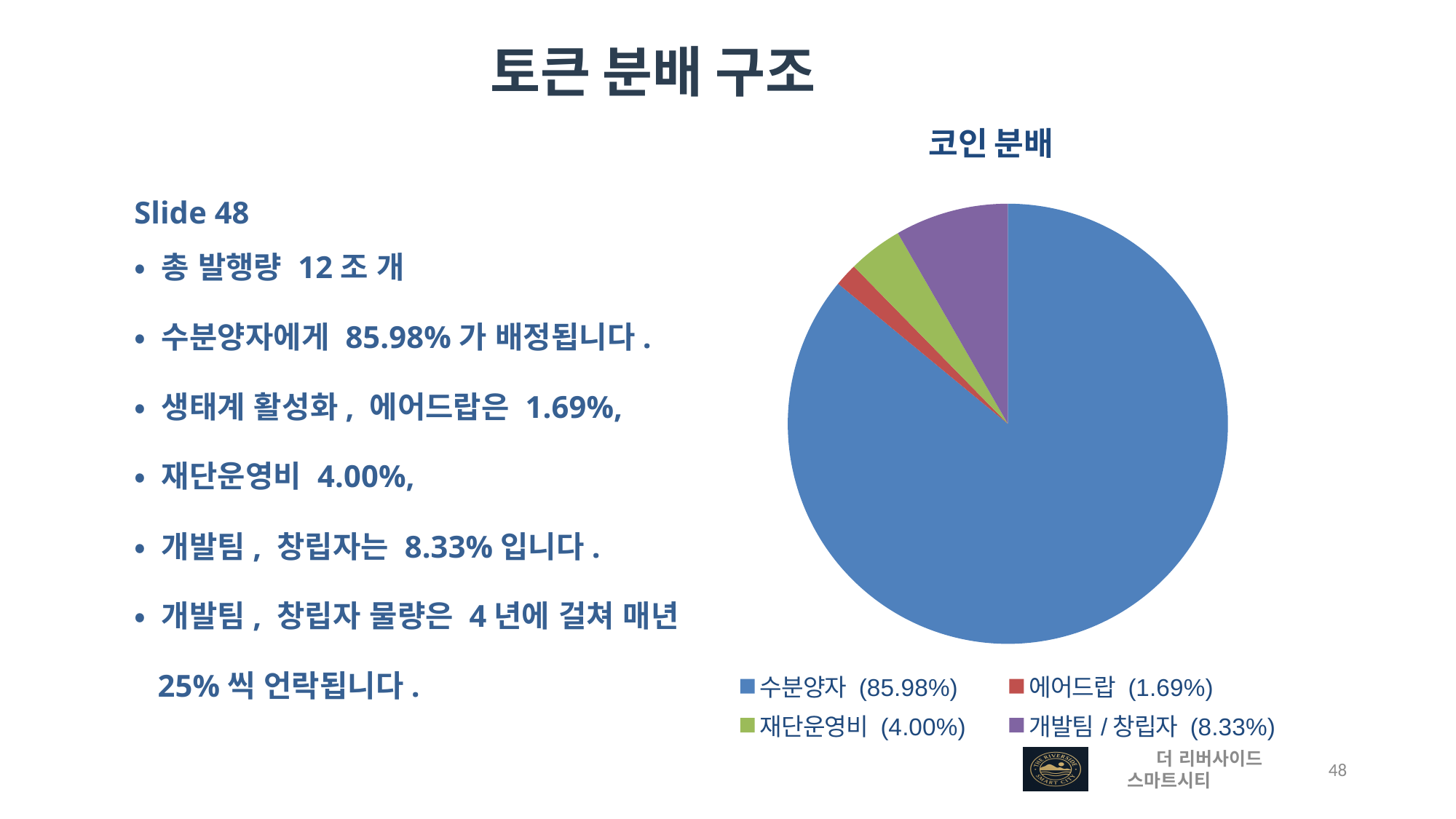
Which category has the largest slice of the pie? 수분양자 What share of the pie does 수분양자 hold? 85.98% What share of the pie does 개발팀 / 창립자 hold? 8.33% What colour is the 수분양자 slice in the pie chart? Blue What is the title of the pie chart? 코인 분배 Which is larger, the share for 재단운영비 or the share for 개발팀 / 창립자? 개발팀 / 창립자 What kind of chart is shown on the slide? Pie chart What share of the pie does 에어드랍 hold? 1.69% What is the difference in percentage points between the 개발팀 / 창립자 share and the 재단운영비 share? 4.33 How many slices does the pie chart have? 4 Which category has the smallest slice of the pie? 에어드랍